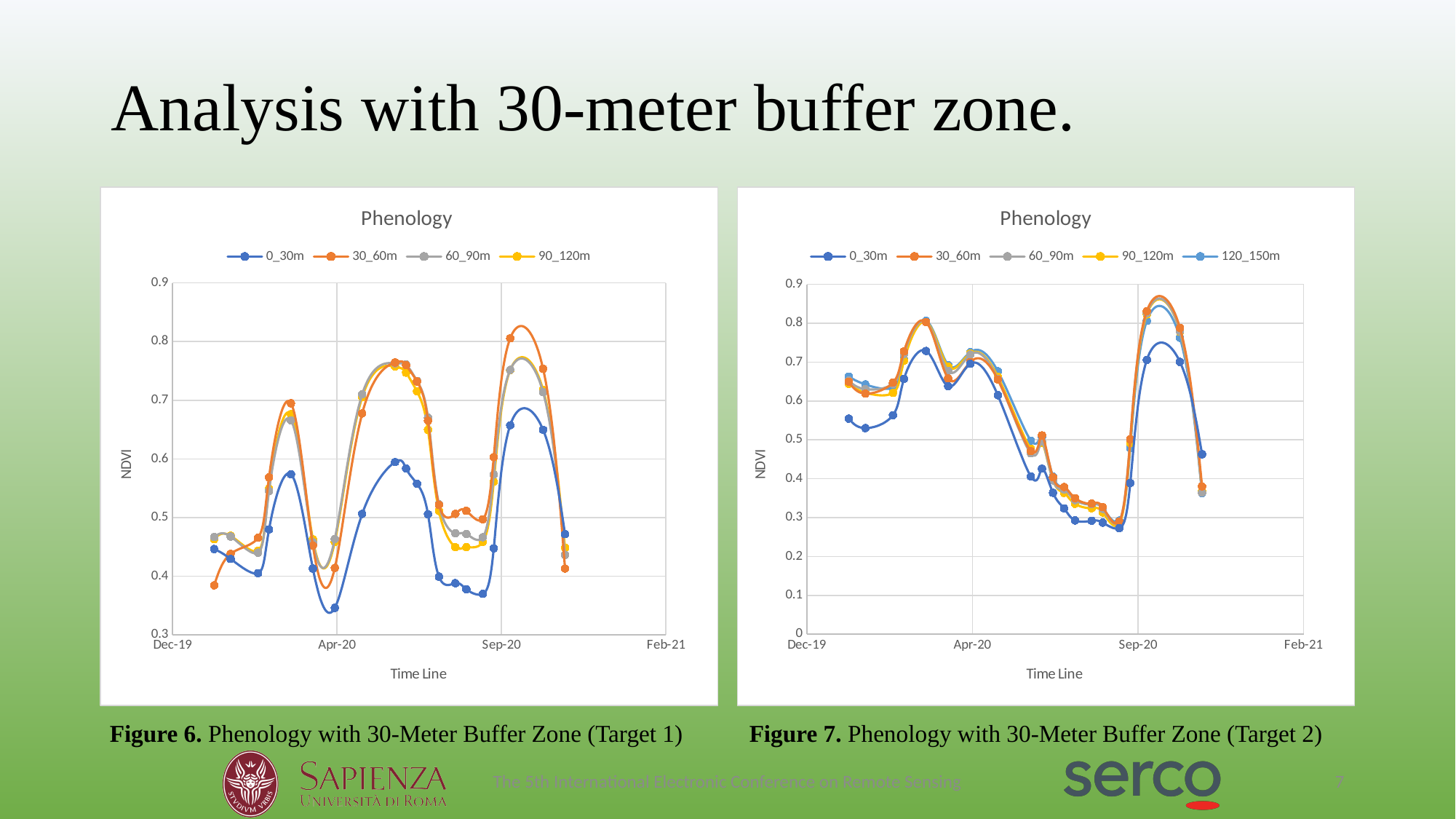
In Figure 6 (the left chart), is the highest value of the 0_30m series greater or less than 0.7? less What is the label of the y axis in Figure 7 (the right chart)? NDVI How many series does the legend of Figure 6 (the left chart) list? 4 In Figure 6 (the left chart), at the peak around Sep-20, is the 30_60m series higher or lower than the 0_30m series? higher In Figure 6 (the left chart), is the highest value of the 30_60m series greater or less than 0.8? greater What is the title of the left chart (Figure 6)? Phenology In Figure 6 (the left chart), which series reaches the highest peak around Sep-20? 30_60m In Figure 7 (the right chart), is the highest value of the 0_30m series greater or less than 0.7? greater What kind of chart is Figure 6 (the left chart)? line chart How many series does the legend of Figure 7 (the right chart) list? 5 In Figure 7 (the right chart), which series has the lowest peak around Sep-20? 0_30m